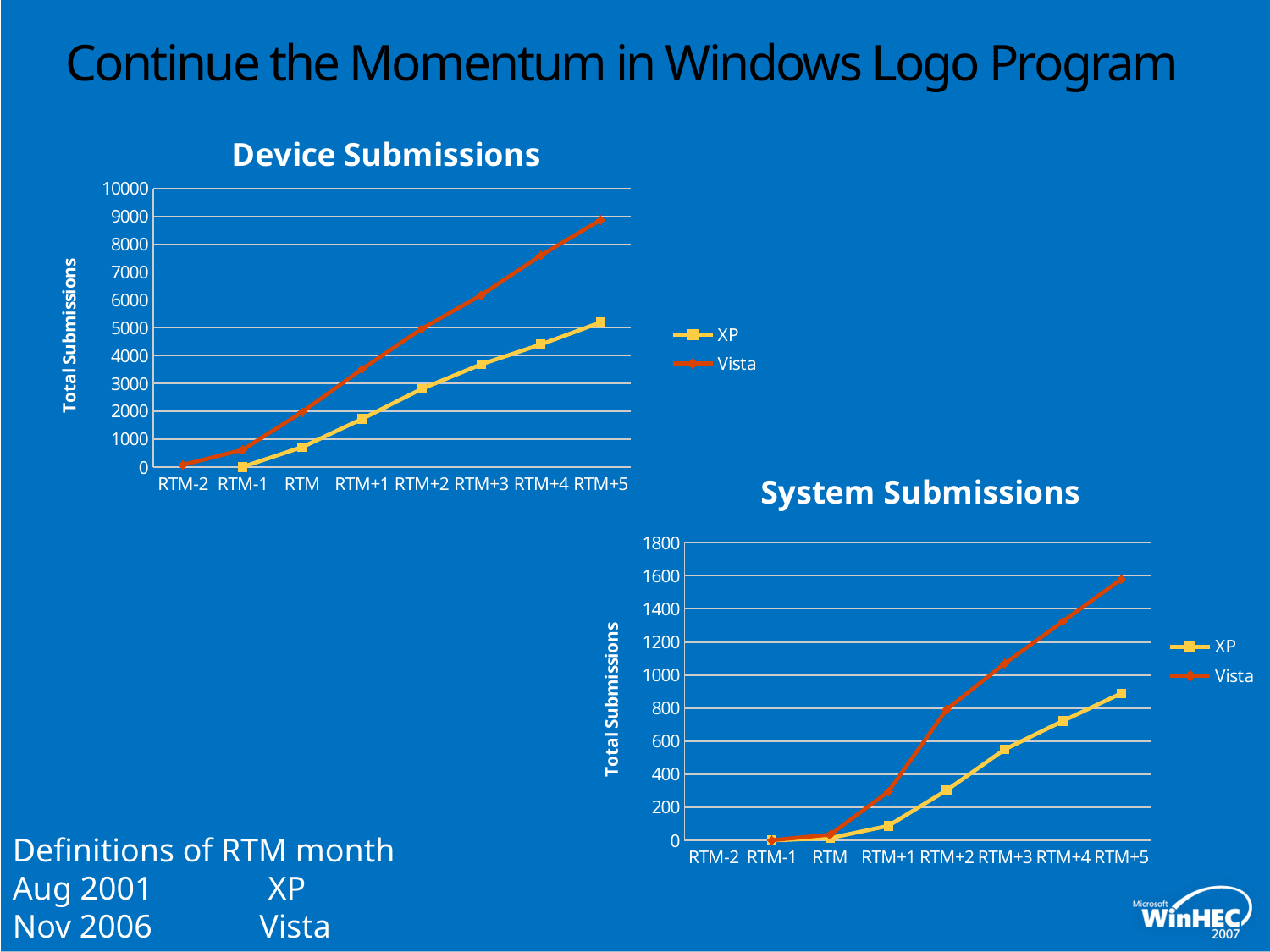
In the Device Submissions chart, is the XP value at RTM+1 greater or less than 2000? less In the System Submissions chart, which series is higher at RTM+4, XP or Vista? Vista In the Device Submissions chart, is the Vista value at RTM+5 greater or less than 8000? greater What kind of chart is the Device Submissions chart? line chart In the System Submissions chart, is the Vista value at RTM+5 greater or less than 1400? greater What is the y-axis label of the System Submissions chart? Total Submissions In the System Submissions chart, at which category does the XP series reach its highest value? RTM+5 In the Device Submissions chart, do the Vista values rise or fall from RTM-2 to RTM+5? rise How many categories are shown on the x axis of the Device Submissions chart? 8 How many series does the legend of the System Submissions chart list? 2 In the Device Submissions chart, which series is higher at RTM+5, XP or Vista? Vista